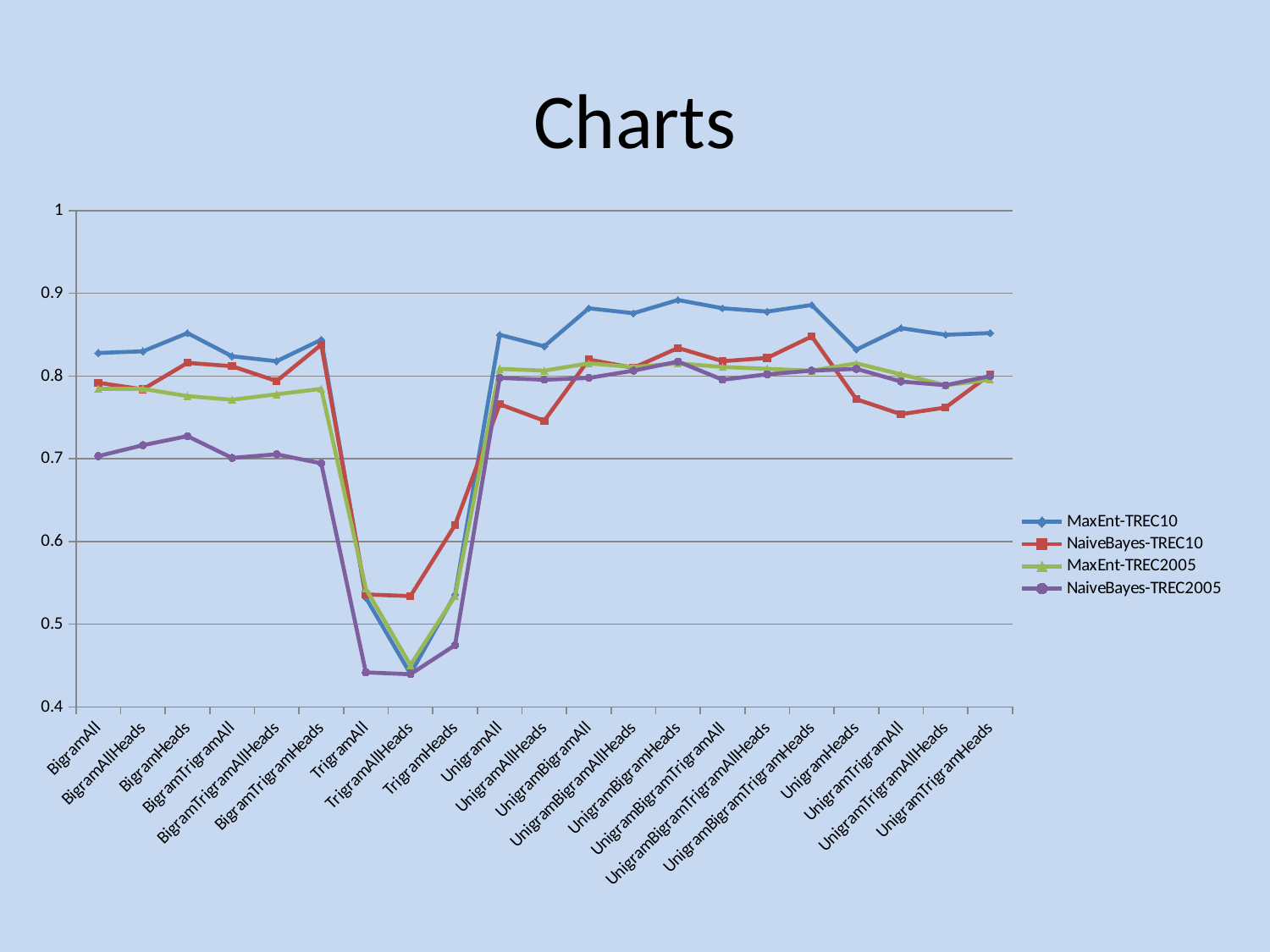
How many series does the legend list? 4 Is the value for MaxEnt-TREC10 at TrigramAllHeads greater or less than 0.5? less Is the value for NaiveBayes-TREC2005 at TrigramHeads greater or less than 0.5? less What kind of chart is shown on the slide? Line chart Is the value for NaiveBayes-TREC2005 at BigramHeads greater or less than 0.7? greater What is the title of the slide containing the chart? Charts How many categories are plotted along the x axis? 21 Does the MaxEnt-TREC10 series rise or fall from BigramTrigramHeads to TrigramAllHeads? Fall Which series has the highest value at UnigramAll? MaxEnt-TREC10 At BigramAll, which is larger: MaxEnt-TREC10 or NaiveBayes-TREC2005? MaxEnt-TREC10 At which category does the MaxEnt-TREC10 series reach its lowest value? TrigramAllHeads